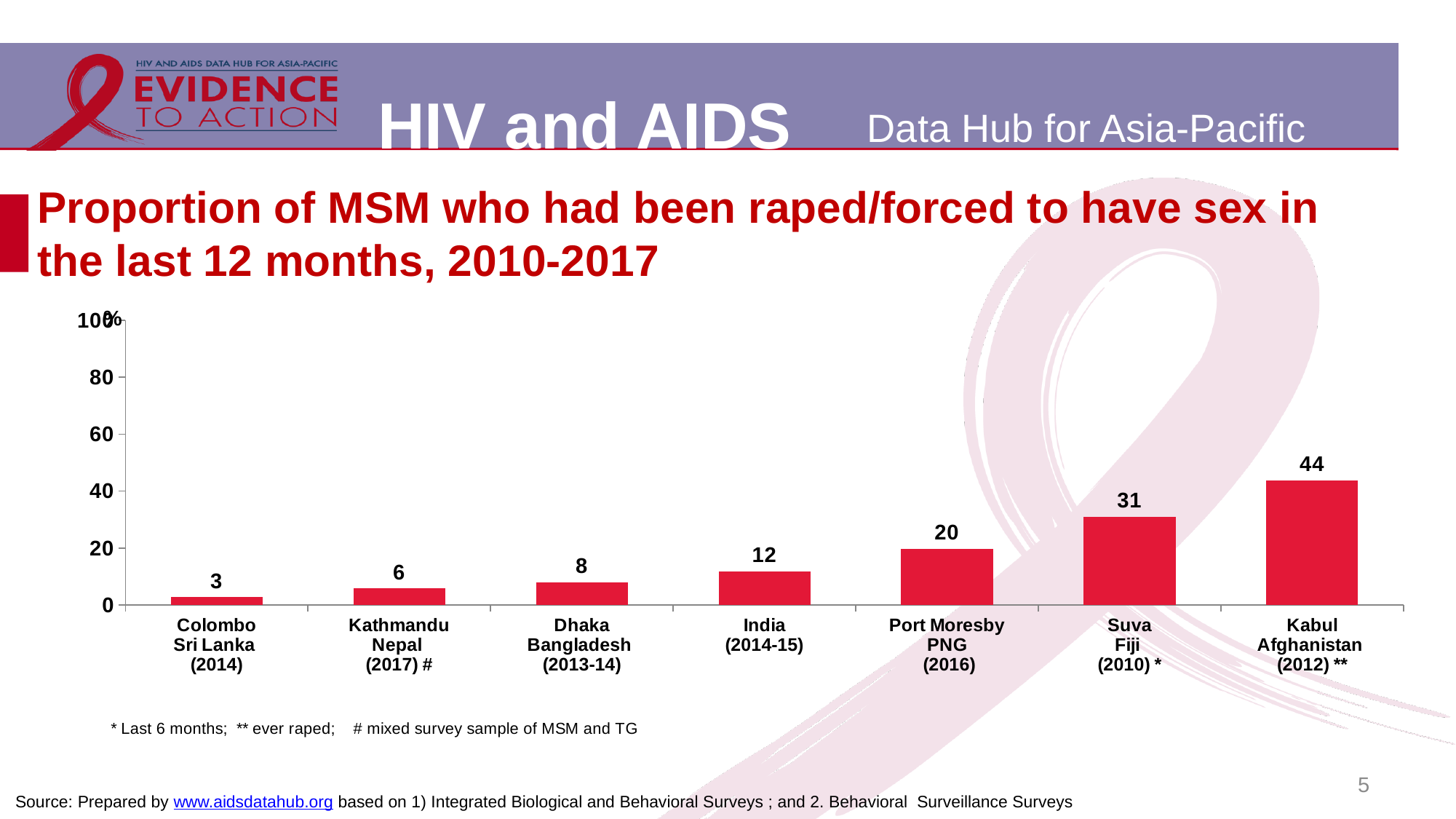
What is the value for Port Moresby, PNG (2016)? 20 Which is larger, the value for Kathmandu, Nepal or the value for Port Moresby, PNG? Port Moresby, PNG Do the values rise or fall from left to right across the chart? rise Which location has the highest proportion? Kabul, Afghanistan What kind of chart is shown on the slide? bar chart What is the maximum value shown on the vertical axis? 100 What is the value for Kabul, Afghanistan (2012)? 44 Is the value for Kabul, Afghanistan greater or less than 40? greater Which location has the lowest proportion? Colombo, Sri Lanka What is the value for Dhaka, Bangladesh (2013-14)? 8 How many locations are shown on the chart? 7 What is the difference between the values for Suva, Fiji and India? 19